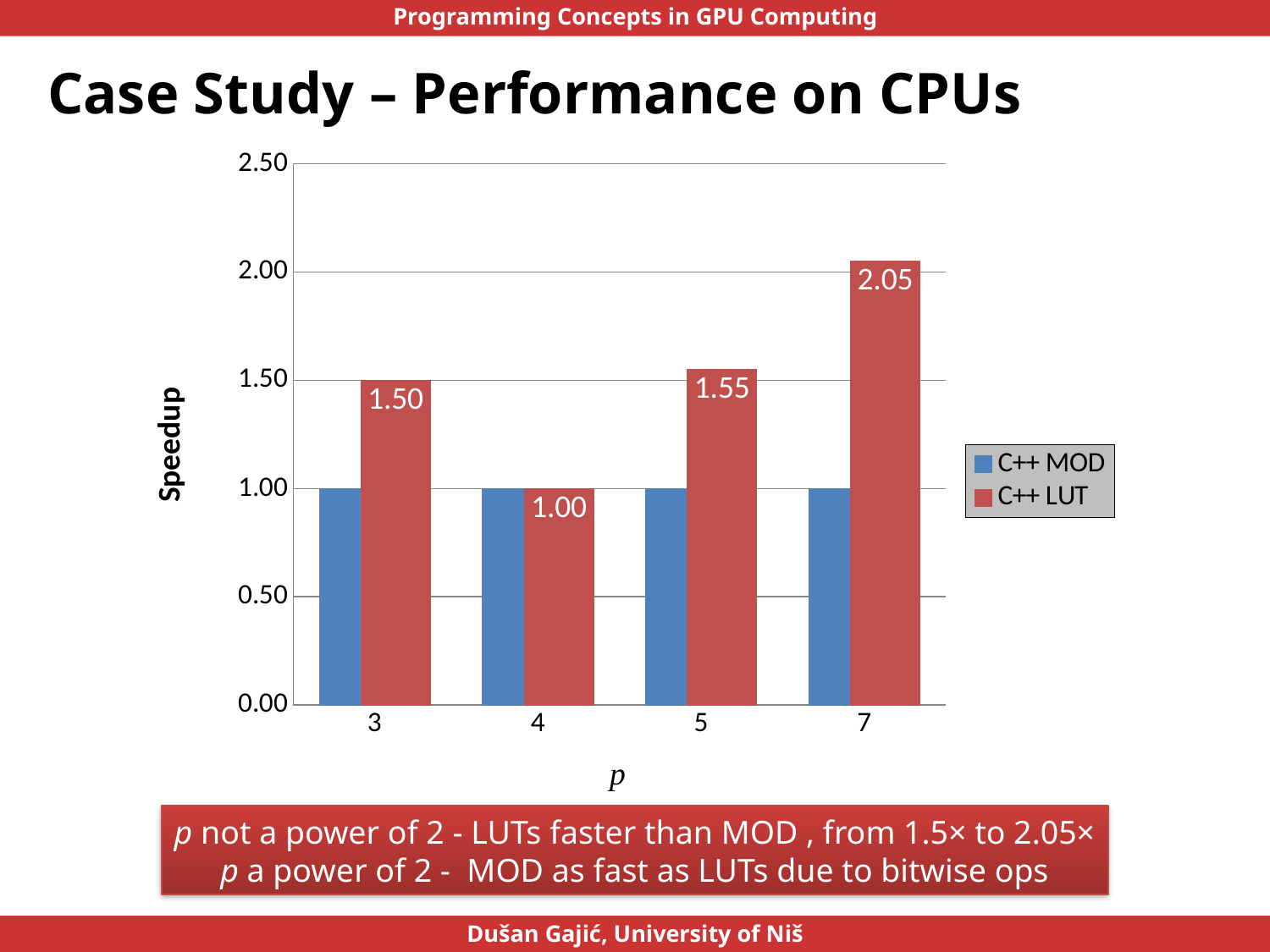
Is the C++ LUT speedup at p = 7 greater or less than 2.00? greater What is the label of the y axis? Speedup How many values of p are shown on the x axis? 4 For which value of p is the C++ LUT speedup lowest? 4 What is the difference between the C++ LUT speedup at p = 7 and at p = 3? 0.55 What is the speedup of C++ LUT at p = 4? 1.00 What kind of chart is shown on the slide? bar chart What is the speedup of C++ LUT at p = 7? 2.05 For which value of p is the C++ LUT speedup highest? 7 What is the speedup of C++ LUT at p = 3? 1.50 How many series does the legend list? 2 Which has a larger C++ LUT speedup, p = 5 or p = 3? p = 5